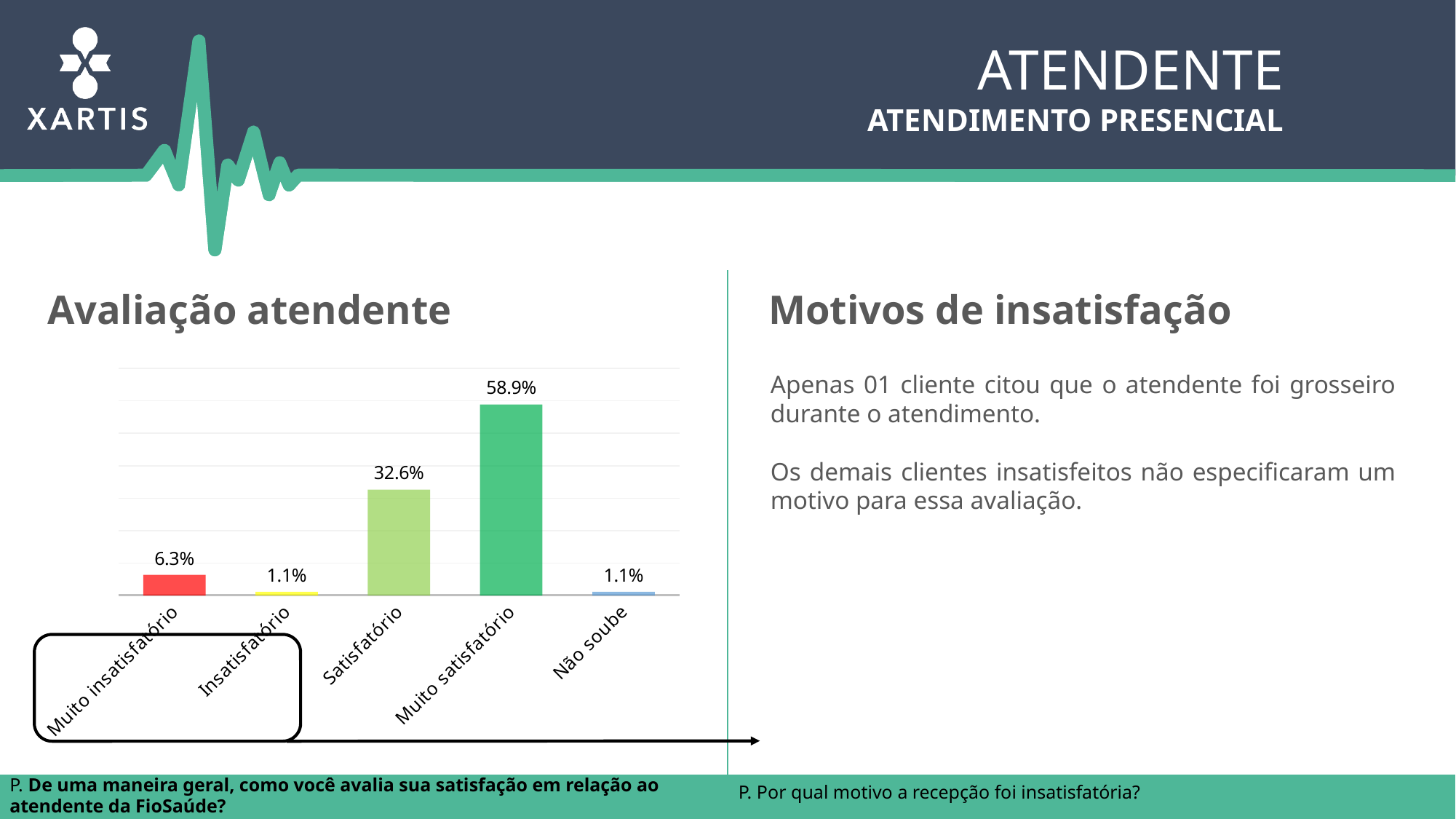
What kind of chart is shown? Bar chart What is the value for Satisfatório? 32.6% What is the value for Muito satisfatório? 58.9% What is the title of the chart? Avaliação atendente What is the value for Muito insatisfatório? 6.3% What is the difference between Muito insatisfatório and Insatisfatório? 5.2% What is the difference between Muito satisfatório and Satisfatório? 26.3% What is the value for Não soube? 1.1% How many categories are shown on the x axis? 5 Which category has the highest value? Muito satisfatório Which is larger, Satisfatório or Muito insatisfatório? Satisfatório What is the combined value of Muito insatisfatório and Insatisfatório? 7.4%